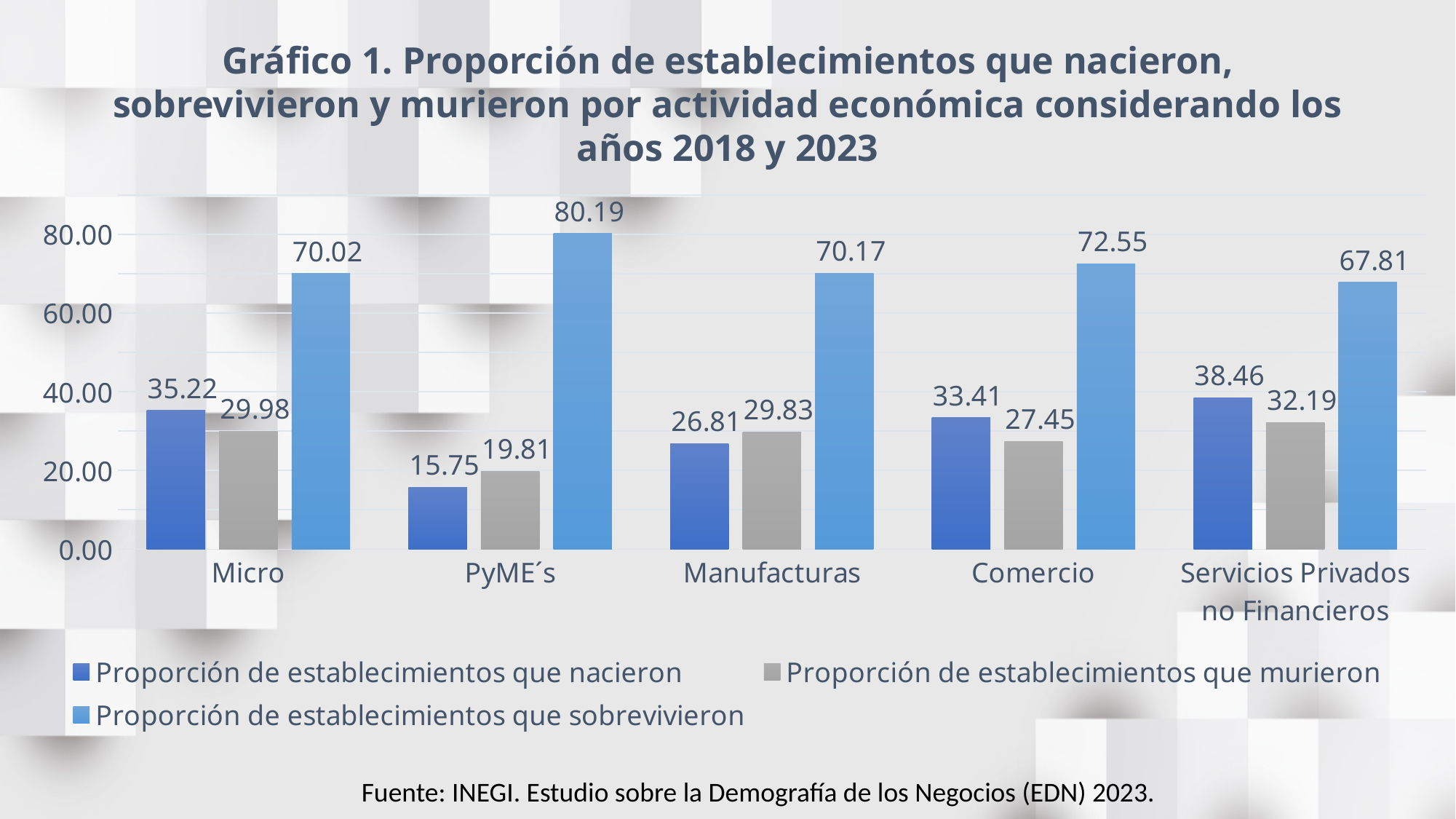
What is the value of 'Proporción de establecimientos que sobrevivieron' for PyME´s? 80.19 What is the value of 'Proporción de establecimientos que murieron' for Comercio? 27.45 For Manufacturas, which is larger: 'Proporción de establecimientos que nacieron' or 'Proporción de establecimientos que murieron'? Proporción de establecimientos que murieron Which category has the lowest value for 'Proporción de establecimientos que nacieron'? PyME´s What is the difference between 'Proporción de establecimientos que nacieron' and 'Proporción de establecimientos que murieron' for Servicios Privados no Financieros? 6.27 What is the value of 'Proporción de establecimientos que nacieron' for Micro? 35.22 Which category has the highest value for 'Proporción de establecimientos que sobrevivieron'? PyME´s How many categories are shown on the x axis? 5 Is the value of 'Proporción de establecimientos que sobrevivieron' for Micro greater or less than 60.00? greater What is the source cited below the chart? INEGI. Estudio sobre la Demografía de los Negocios (EDN) 2023. How many series does the legend list? 3 What kind of chart is shown on the slide? Bar chart